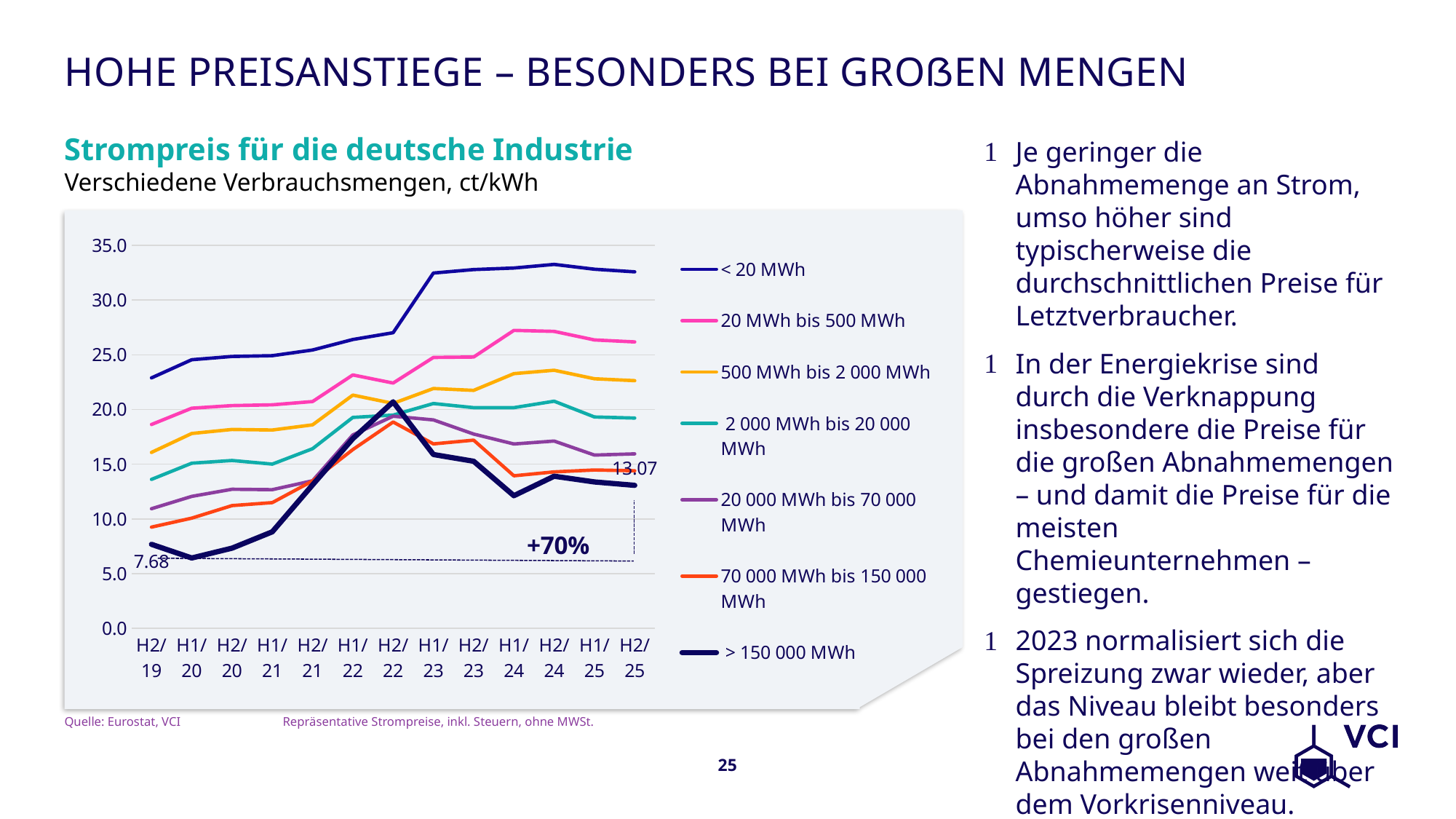
In H2/19, which is larger: the value for < 20 MWh or the value for > 150 000 MWh? < 20 MWh How many series does the legend list? 7 Which series has the highest value in H2/25? < 20 MWh Is the value for < 20 MWh in H2/25 greater or less than 30.0? greater What is the value for > 150 000 MWh in H2/19? 7.68 What is the value for > 150 000 MWh in H2/25? 13.07 Is the value for 20 MWh bis 500 MWh in H2/19 greater or less than 20.0? less What kind of chart is shown on the slide? line chart What is the difference between the > 150 000 MWh values in H2/25 and H2/19? 5.39 How many time periods are shown on the x axis? 13 What percentage change is annotated on the chart for the > 150 000 MWh series? +70% Which series has the lowest value in H2/25? > 150 000 MWh